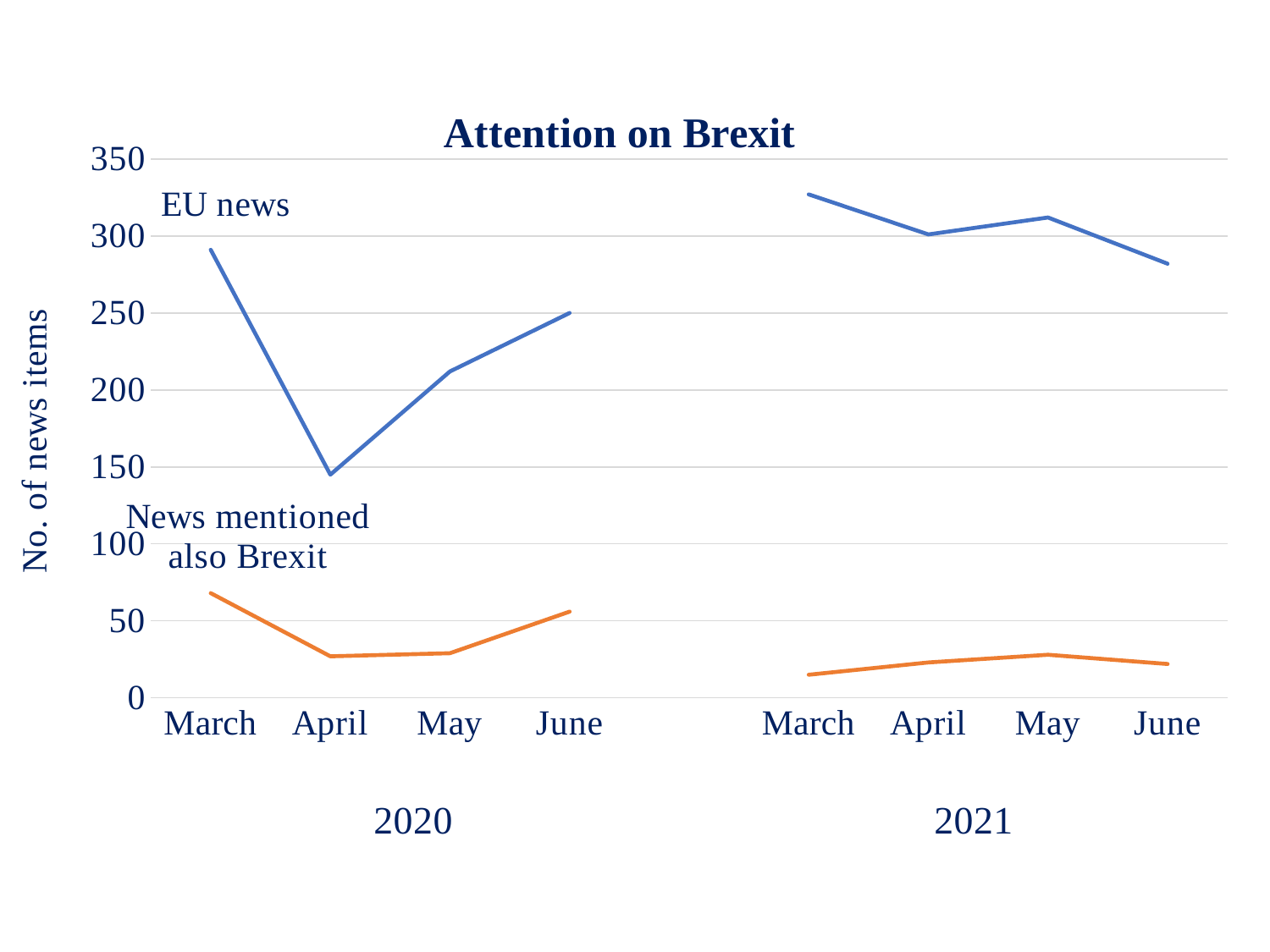
How many series are plotted in the chart? 2 Does the EU news line rise or fall from April 2020 to June 2020? rise In which month and year is the EU news line at its highest? March 2021 Is the EU news value for March 2021 greater or less than 300? greater What is the title of the chart? Attention on Brexit Is the 'News mentioned also Brexit' value for April 2020 greater or less than 50? less In which month and year is the EU news line at its lowest? April 2020 Which is larger for EU news: March 2020 or June 2020? March 2020 Is the EU news value for April 2020 greater or less than 200? less What kind of chart is shown on the slide? line chart How many data points does the EU news line have? 8 In which month and year is the 'News mentioned also Brexit' line at its highest? March 2020